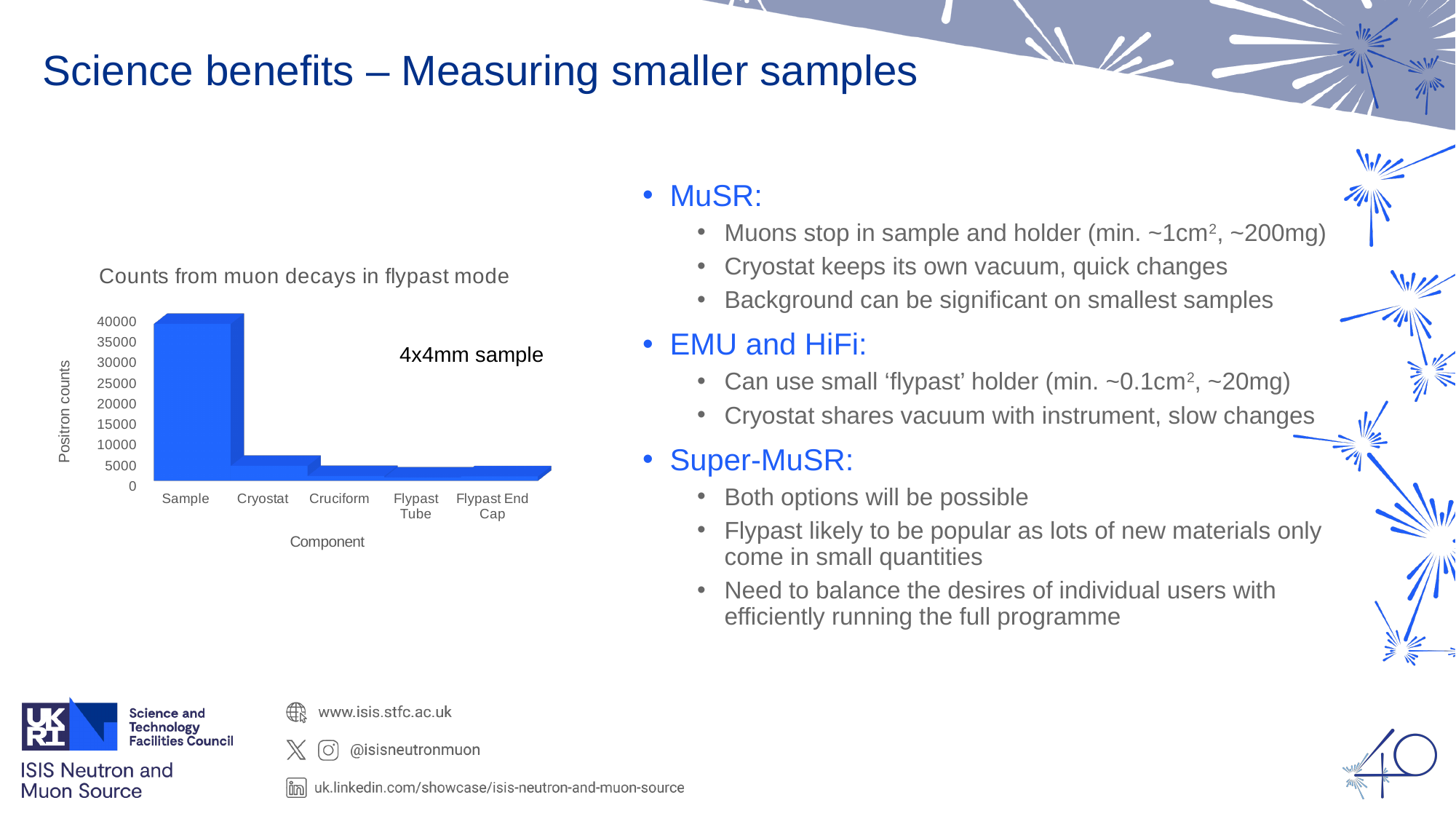
Which has higher positron counts, Cryostat or Cruciform? Cryostat What is the label of the y axis of the chart? Positron counts Do the positron counts generally rise or fall from Sample to Flypast Tube along the x axis? fall Which has higher positron counts, Sample or Cryostat? Sample Is the value for Cryostat greater or less than 10000? less What kind of chart is shown on the slide? Bar chart Is the value for Sample greater or less than 35000? greater Is the value for Flypast Tube greater or less than 5000? less Which component has the highest positron counts? Sample How many components are plotted on the x axis of the chart? 5 What is the title of the chart? Counts from muon decays in flypast mode